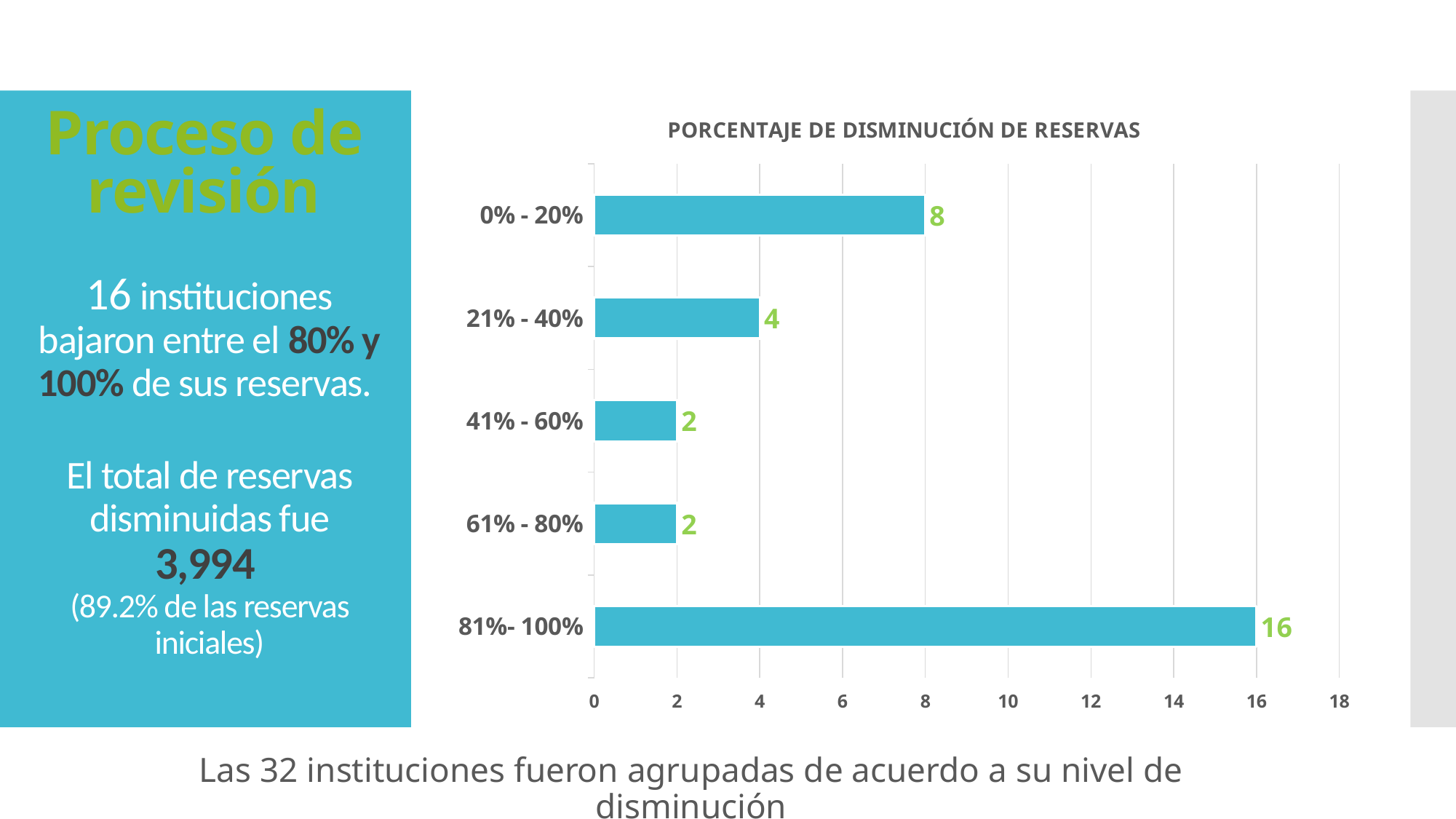
What is the highest value shown on the horizontal axis? 18 How many categories are shown in the chart? 5 What is the difference between the values for 81%- 100% and 0% - 20%? 8 Is the value for 81%- 100% greater or less than 10? greater What is the value for the 21% - 40% category? 4 What is the value for the 0% - 20% category? 8 What is the value for the 81%- 100% category? 16 Which is larger, the value for 0% - 20% or the value for 21% - 40%? 0% - 20% What is the difference between the values for 21% - 40% and 41% - 60%? 2 What is the title of the chart? PORCENTAJE DE DISMINUCIÓN DE RESERVAS Which category has the highest value? 81%- 100% What kind of chart is shown on the slide? Bar chart